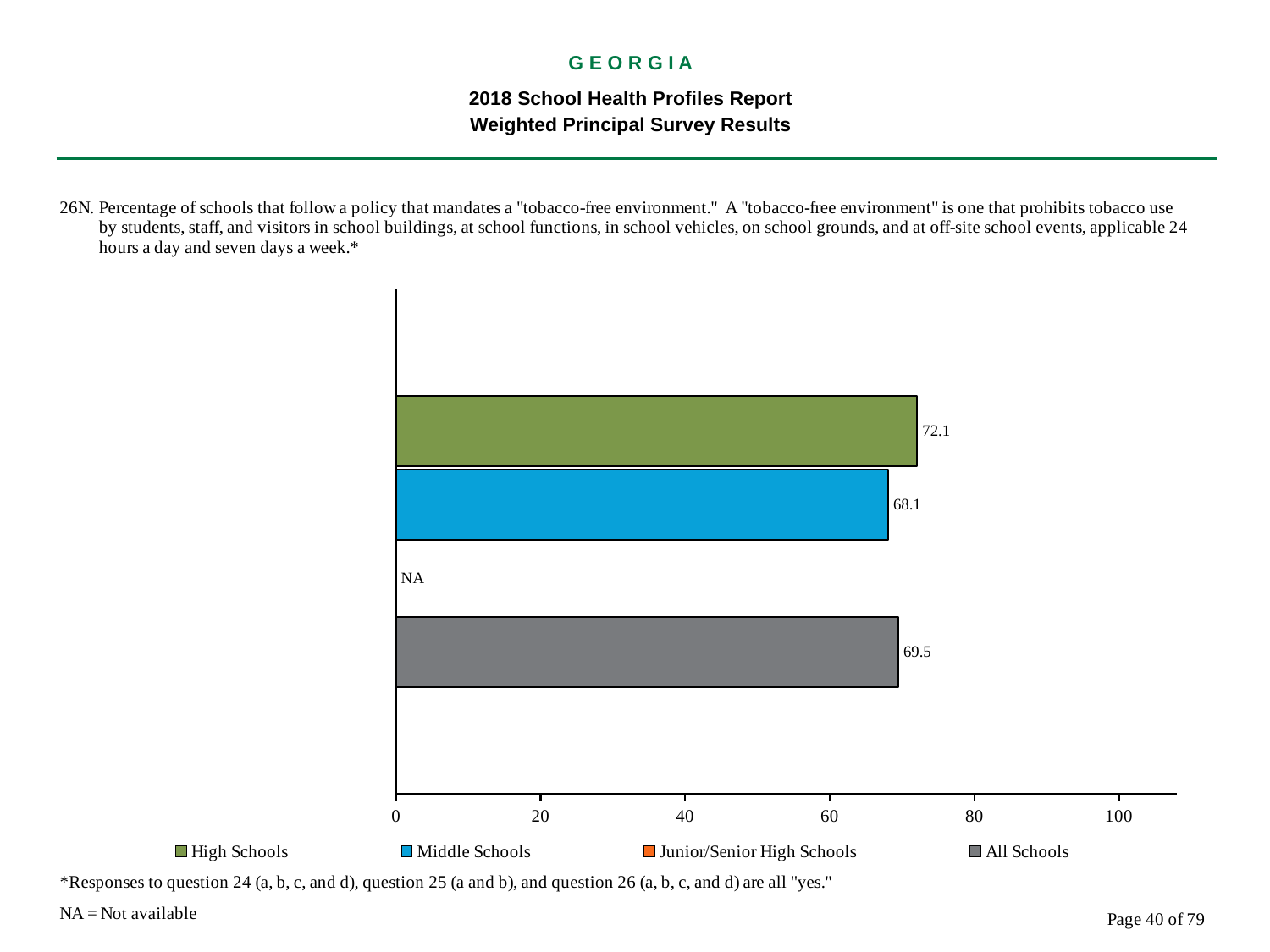
What is the value for All Schools? 69.5 What is the value for High Schools? 72.1 Which school type with a plotted bar has the lowest value? Middle Schools What is the value for Middle Schools? 68.1 Which is larger, the value for All Schools or the value for Middle Schools? All Schools What is the difference between the High Schools and All Schools values? 2.6 What is the difference between the High Schools and Middle Schools values? 4.0 What kind of chart is shown on the slide? bar chart How many series does the legend list? 4 Which school type has the highest value? High Schools What is shown for Junior/Senior High Schools? NA Is the value for High Schools greater or less than 60? greater